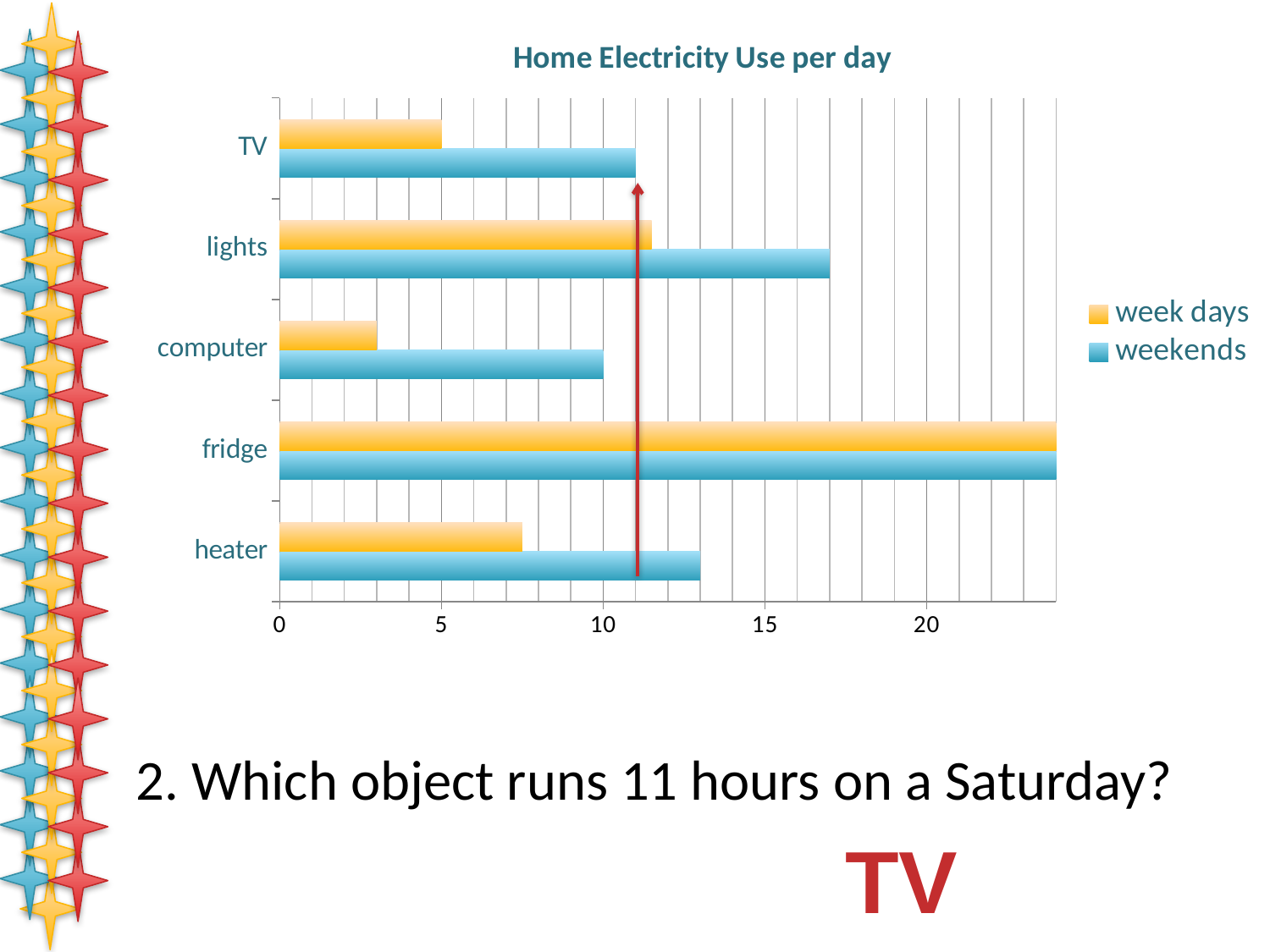
How many series does the legend list in the Home Electricity Use per day chart? 2 How many hours per day is the TV used on weekends? 11 Is the week days value for fridge greater or less than 20? greater Which object has the highest weekend electricity use? fridge Which object has the lowest week days electricity use? computer On weekends, which is used for more hours: lights or heater? lights How many objects (categories) are shown in the Home Electricity Use per day chart? 5 How many hours per day is the TV used on week days? 5 What kind of chart is shown on the slide? bar chart What is the title of the chart? Home Electricity Use per day Is the weekends value for heater greater or less than 15? less How many hours per day is the computer used on weekends? 10